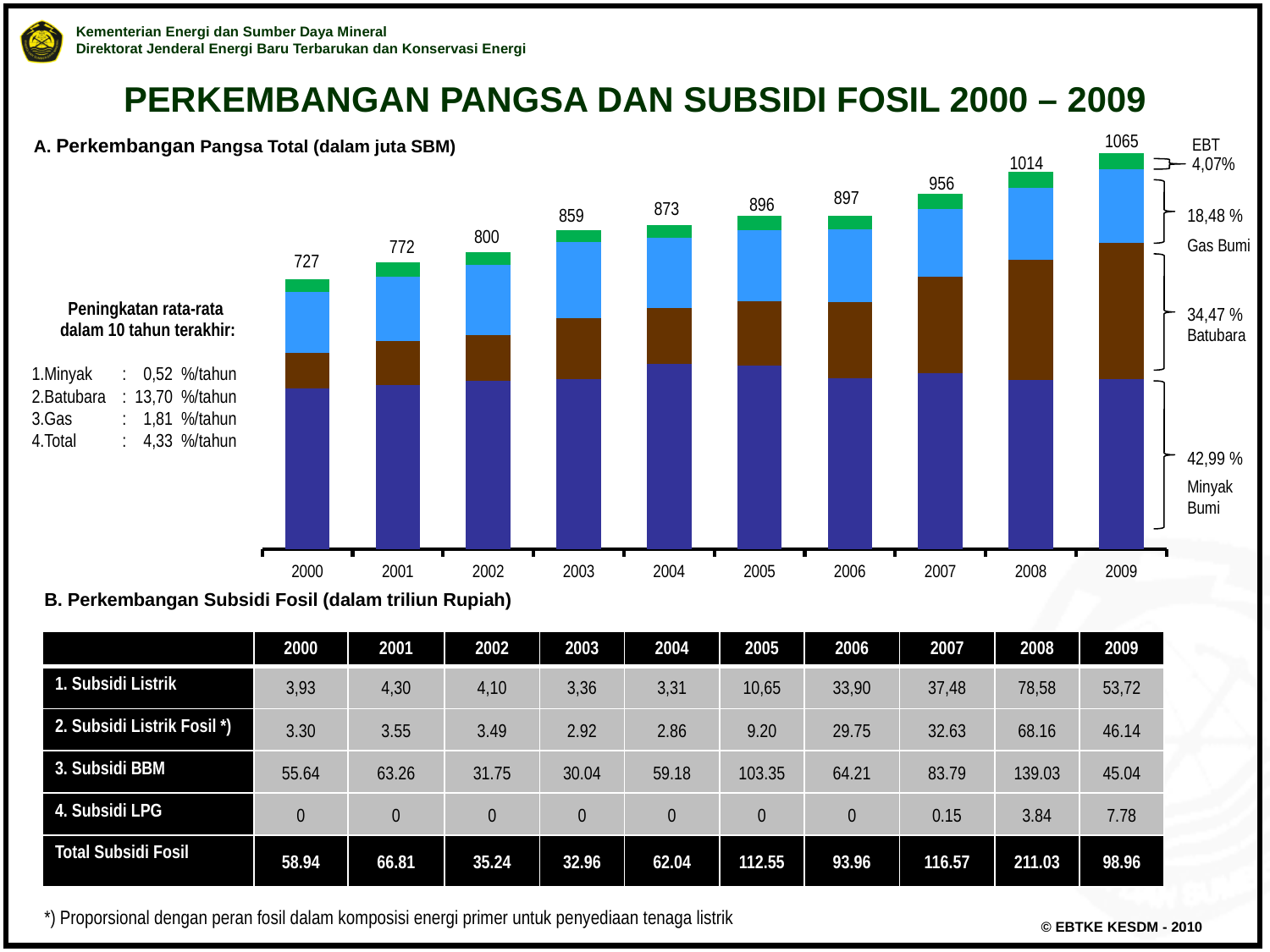
What is the total value shown above the bar for 2009 in the chart 'Perkembangan Pangsa Total'? 1065 In the chart 'Perkembangan Pangsa Total', which is larger, the total for 2003 or the total for 2004? 2004 How many years are shown on the x axis of the chart 'Perkembangan Pangsa Total'? 10 What is the difference between the total for 2009 and the total for 2000 in the chart 'Perkembangan Pangsa Total'? 338 Which year has the highest total in the chart 'Perkembangan Pangsa Total'? 2009 In the chart 'Perkembangan Pangsa Total', what percentage share is labelled for Batubara in 2009? 34,47 % Which year has the lowest total in the chart 'Perkembangan Pangsa Total'? 2000 What is the total value shown above the bar for 2005 in the chart 'Perkembangan Pangsa Total'? 896 What kind of chart is 'Perkembangan Pangsa Total'? Stacked bar chart What is the total value shown above the bar for 2000 in the chart 'Perkembangan Pangsa Total'? 727 Do the totals in the chart 'Perkembangan Pangsa Total' rise or fall from 2000 to 2009? Rise What is the difference between the total for 2008 and the total for 2007 in the chart 'Perkembangan Pangsa Total'? 58